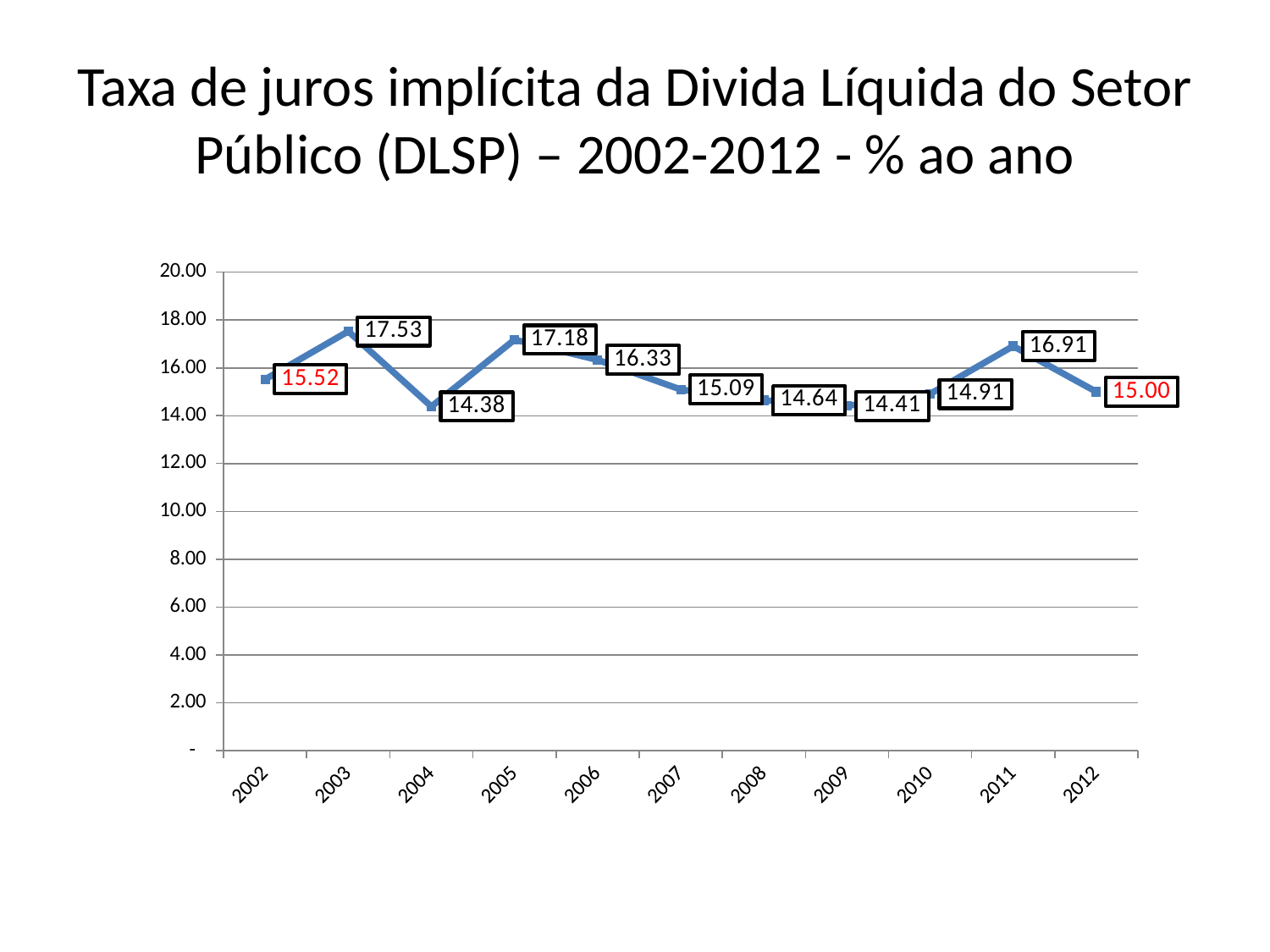
What is the value for 2012? 15.00 Do the values rise or fall from 2011 to 2012? fall Which year has the highest value? 2003 What is the value for 2009? 14.41 Is the value for 2006 greater or less than 16.00? greater What is the difference between the values for 2012 and 2002? -0.52 What is the value for 2003? 17.53 How many years are plotted on the chart? 11 What is the difference between the values for 2003 and 2004? 3.15 Which is larger, the value for 2005 or the value for 2011? 2005 Which year has the lowest value? 2004 What kind of chart is shown on the slide? line chart